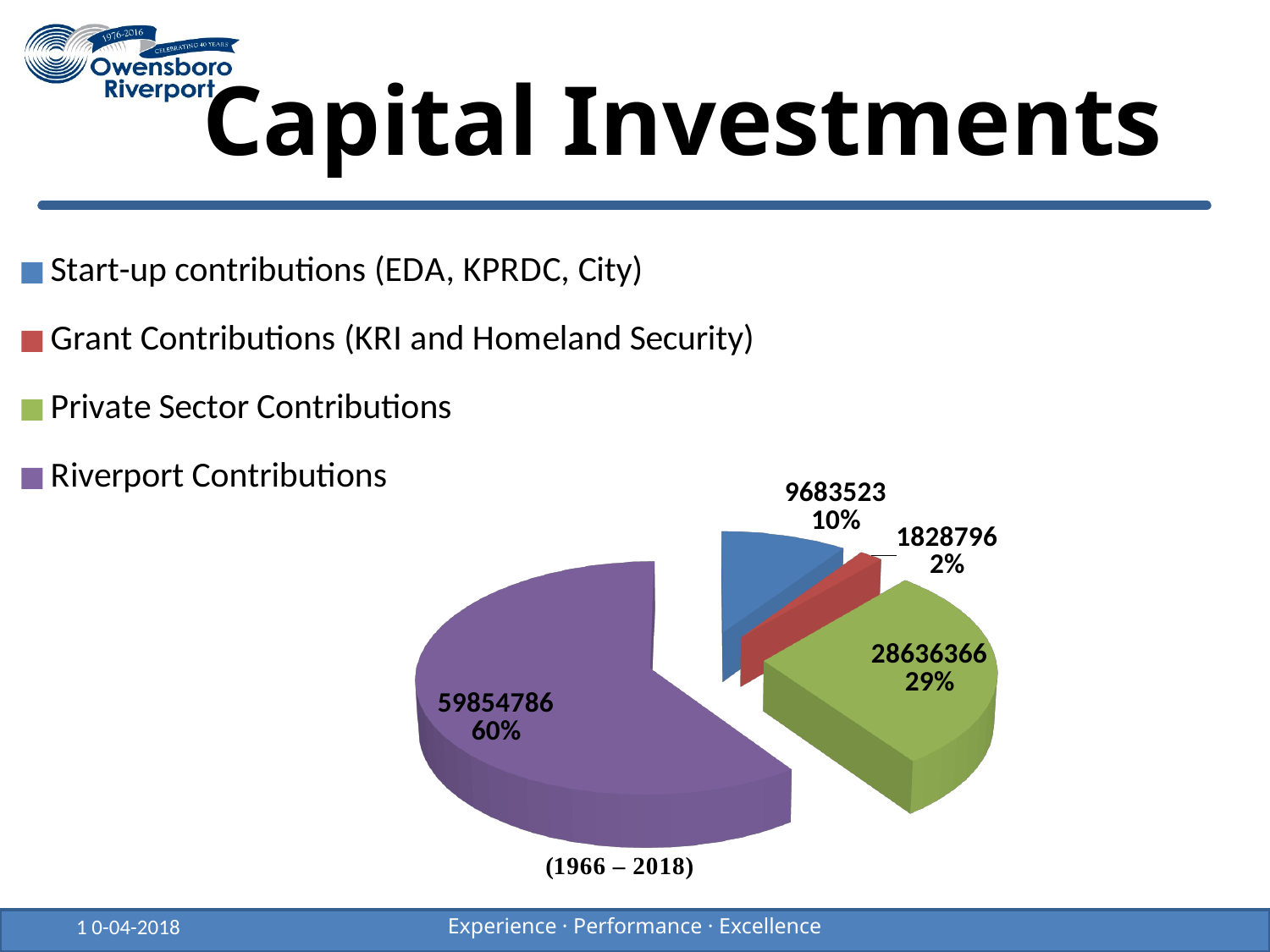
Which category has the largest slice of the pie? Riverport Contributions What kind of chart is shown on the slide? Pie chart Which category has the smallest slice of the pie? Grant Contributions (KRI and Homeland Security) What is the value shown for Private Sector Contributions? 28636366 What share of the pie do Riverport Contributions represent? 60% What share of the pie do Private Sector Contributions represent? 29% What is the value shown for Grant Contributions (KRI and Homeland Security)? 1828796 How many slices does the pie chart have? 4 What is the value shown for Start-up contributions (EDA, KPRDC, City)? 9683523 What is the value shown for Riverport Contributions? 59854786 Which is larger, Start-up contributions (EDA, KPRDC, City) or Private Sector Contributions? Private Sector Contributions How many entries does the legend list? 4